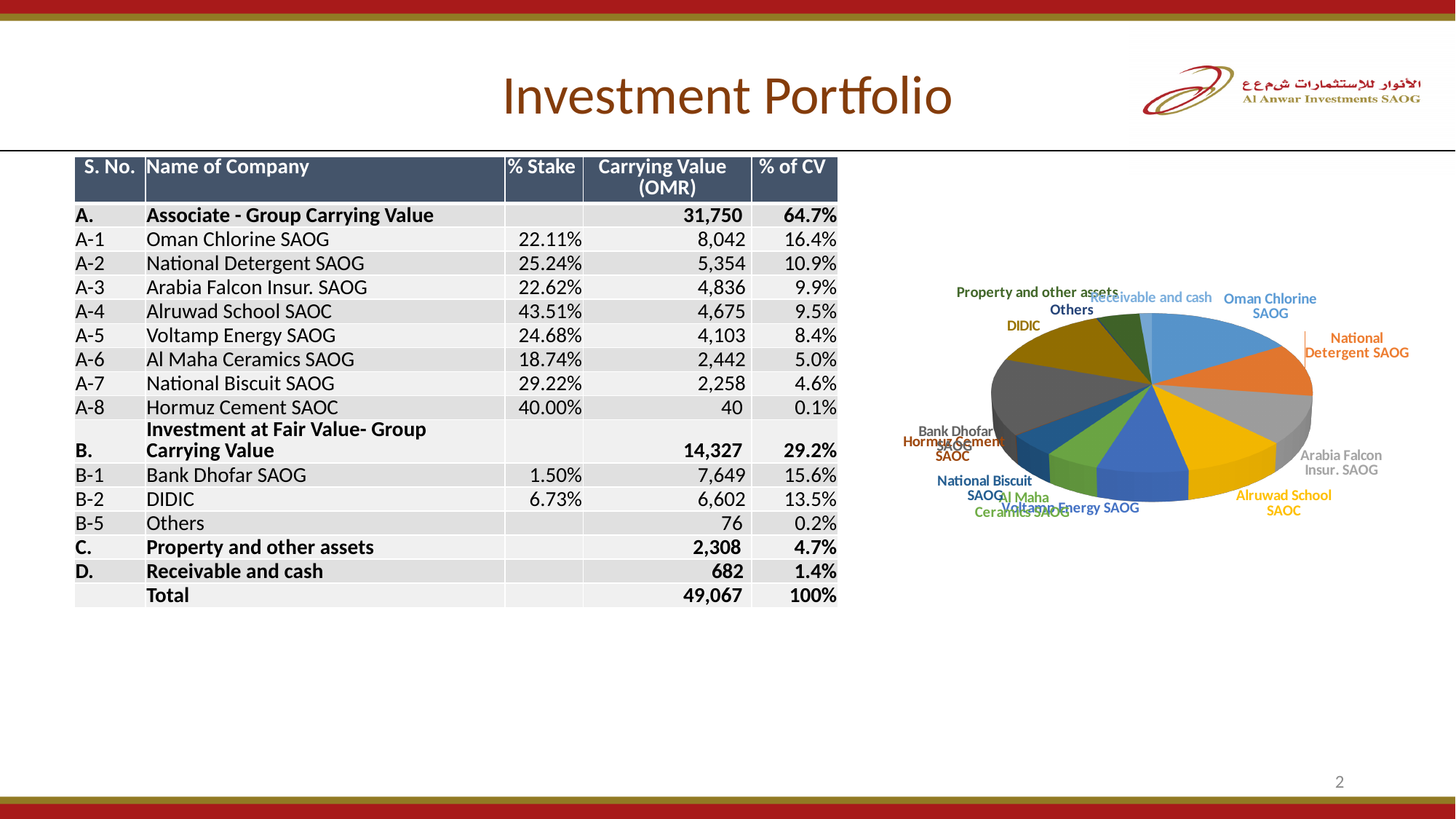
What is the title of the slide containing the pie chart? Investment Portfolio What share of the pie does Bank Dhofar SAOG represent, according to the table on the slide? 15.6% In the pie chart, which slice is larger: DIDIC or Receivable and cash? DIDIC In the pie chart, which slice is larger: Alruwad School SAOC or Others? Alruwad School SAOC What kind of chart is shown on the right side of the slide? pie chart What colour is the National Detergent SAOG slice in the pie chart? orange What share of the pie does DIDIC represent, according to the table on the slide? 13.5% What share of the pie does Oman Chlorine SAOG represent, according to the table on the slide? 16.4% In the pie chart, which slice is larger: Bank Dhofar SAOG or Property and other assets? Bank Dhofar SAOG What is the carrying value (OMR) of the Voltamp Energy SAOG slice, according to the table on the slide? 4,103 What is the carrying value (OMR) of the Receivable and cash slice, according to the table on the slide? 682